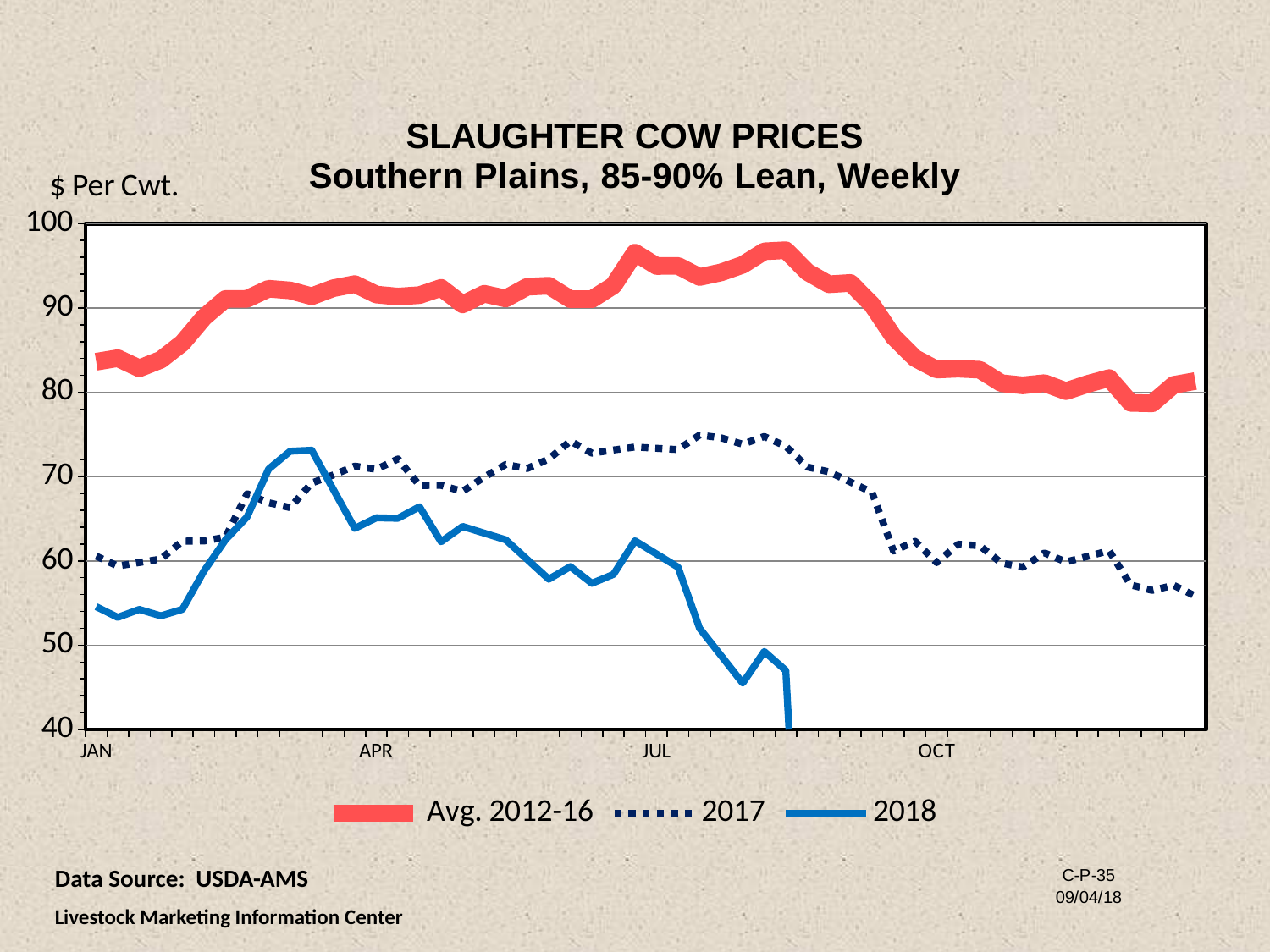
What kind of chart is shown on the slide? line chart What is the title of the chart? SLAUGHTER COW PRICES Southern Plains, 85-90% Lean, Weekly Does the 2018 series rise or fall from JUL to where it ends? fall Is the value for 2018 at JAN greater or less than 50? greater Is the value for Avg. 2012-16 at JAN greater or less than 80? greater At APR, which series is higher, 2017 or 2018? 2017 Is the value for 2017 at JUL greater or less than 70? greater How many series does the legend list? 3 Which series has the highest values across the whole chart? Avg. 2012-16 What unit is shown on the y axis label? $ Per Cwt. At JUL, which series is higher, Avg. 2012-16 or 2017? Avg. 2012-16